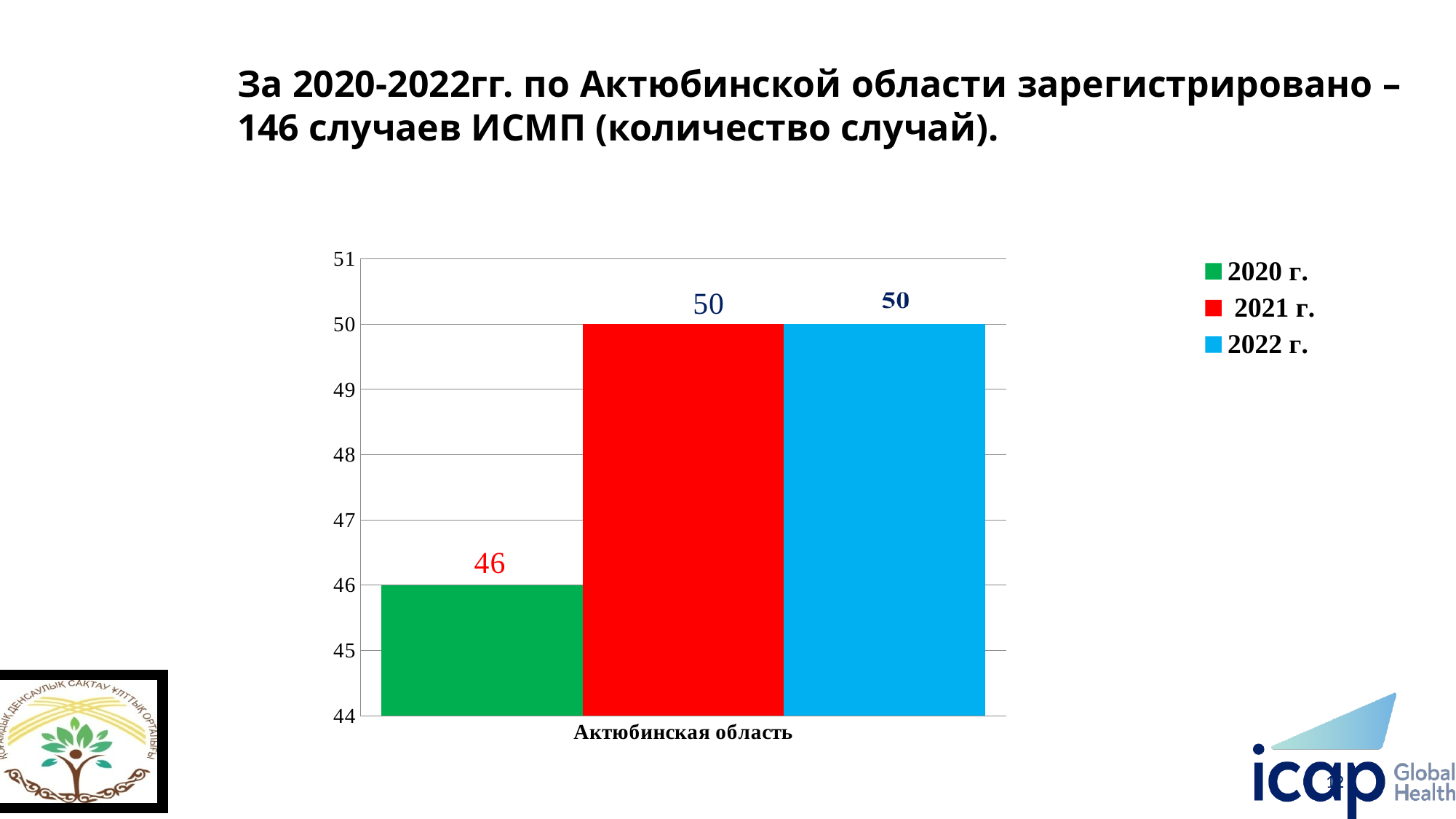
What is the total of the three values shown in the chart? 146 What is the value for 2022 г. in the chart? 50 What colour is the bar for 2021 г.? red Which is larger, the value for 2020 г. or the value for 2022 г.? 2022 г. What is the difference between the values for 2021 г. and 2020 г.? 4 What is the value for 2021 г. in the chart? 50 What kind of chart is shown on the slide? bar chart Is the value for 2020 г. greater or less than 48? less What is the category label on the x axis of the chart? Актюбинская область What is the value for 2020 г. in the chart? 46 How many series does the legend list? 3 Which series has the lowest value in the chart? 2020 г.